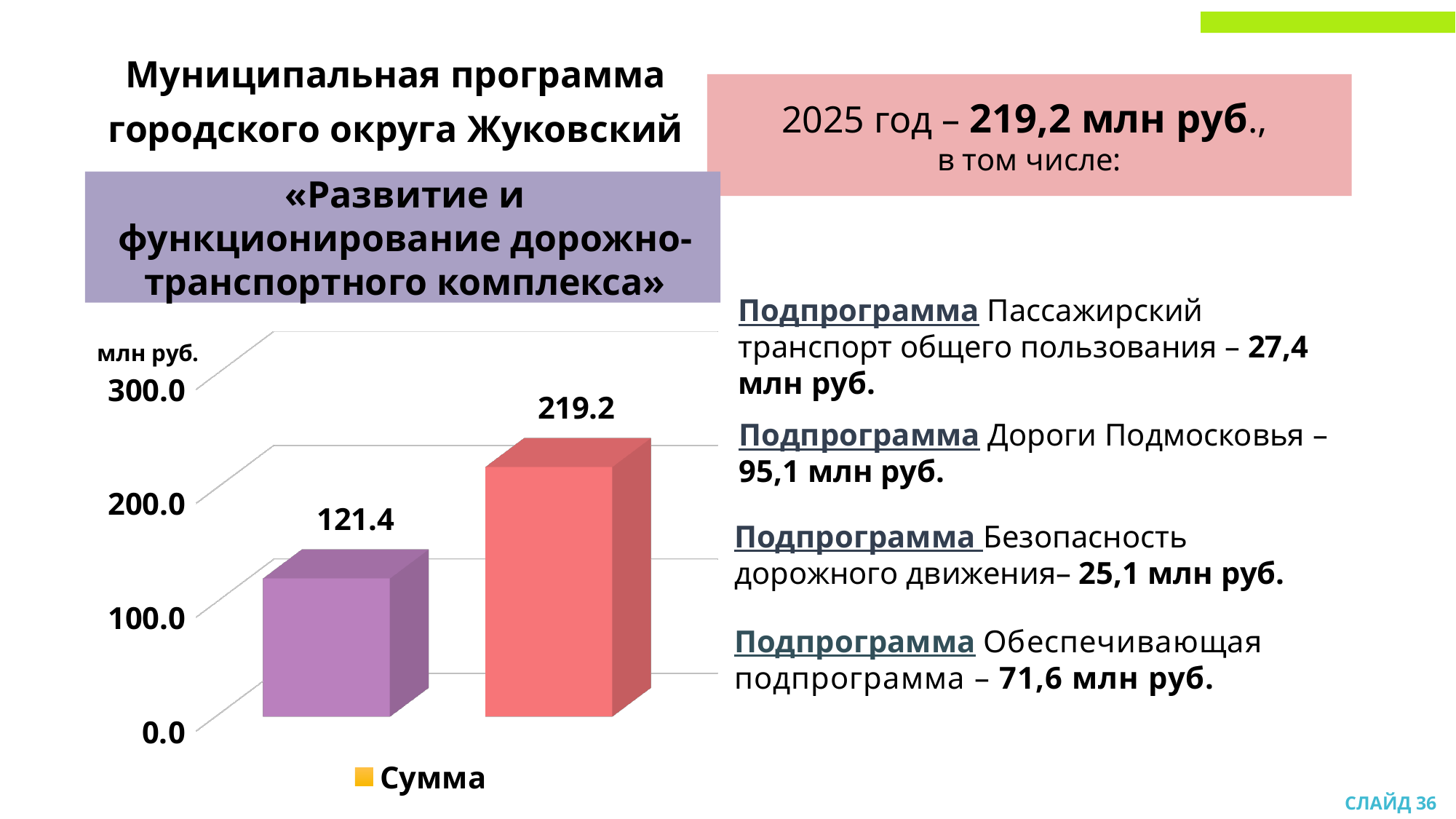
What is the value of the right (red) bar in the chart? 219.2 Which bar in the chart has the highest value, the left purple one or the right red one? the right red bar (219.2) What is the value of the left (purple) bar in the chart? 121.4 Which bar in the chart has the lowest value, the left purple one or the right red one? the left purple bar (121.4) Is the value of the red bar larger or smaller than the value of the purple bar? larger How many bars are plotted in the chart? 2 How many series does the chart legend list? 1 Is the value of the right (red) bar greater or less than 200.0? greater Is the value of the left (purple) bar greater or less than 200.0? less What is the name of the series shown in the chart legend? Сумма What kind of chart is shown on the slide? bar chart What is the difference between the right (red) bar and the left (purple) bar in the chart? 97.8